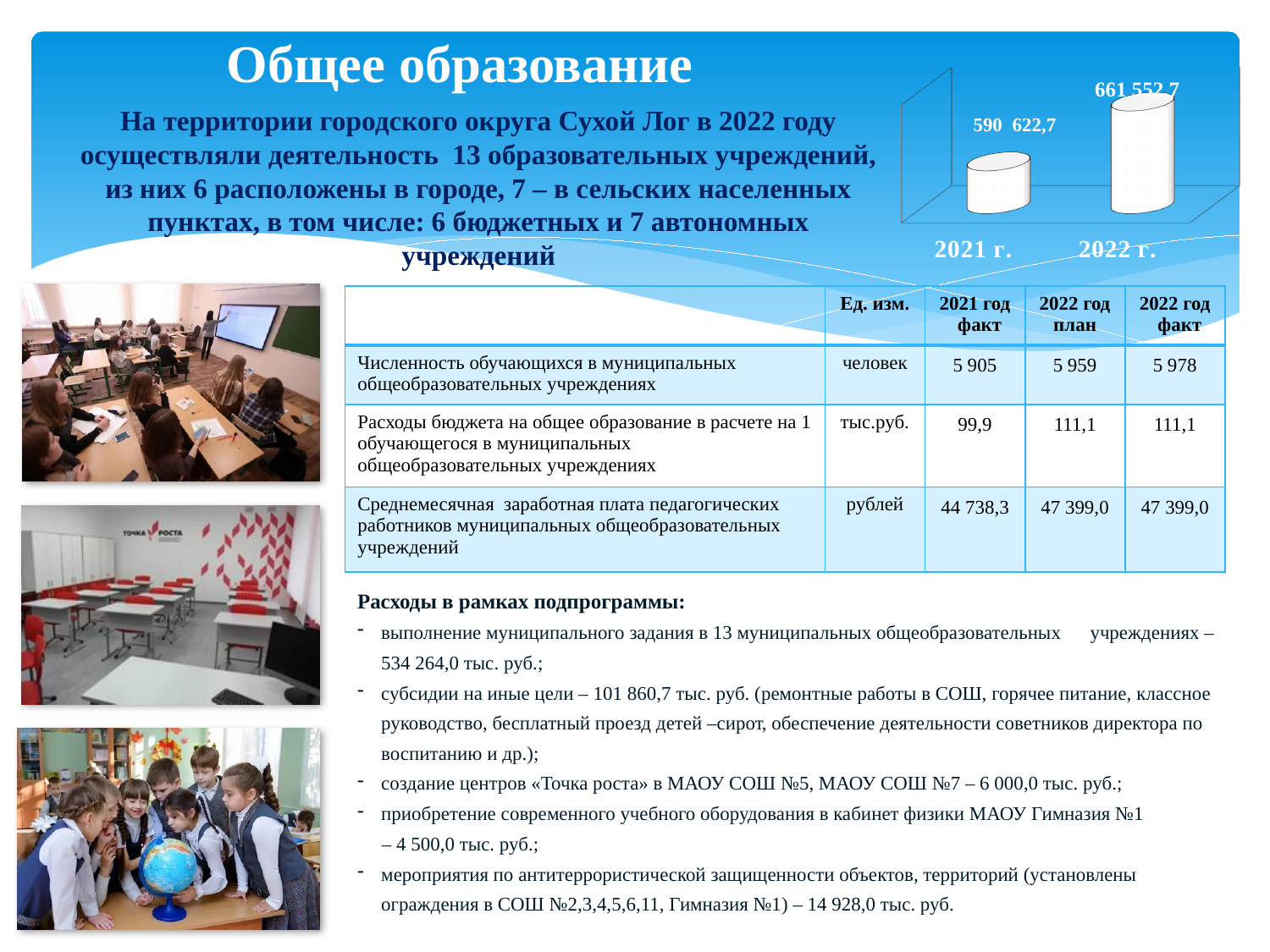
Do the values on the chart rise or fall from 2021 г. to 2022 г.? rise What kind of chart is shown in the top right of the slide? bar chart What value is shown for 2021 г. on the chart? 590 622,7 Is the value for 2021 г. larger or smaller than the value for 2022 г. on the chart? smaller Which year has the higher value on the chart? 2022 г. What are the category labels shown under the bars of the chart? 2021 г. and 2022 г. By how much does the value for 2022 г. exceed the value for 2021 г. on the chart? 70 930,0 Which year has the lower value on the chart? 2021 г. How many categories are plotted on the chart? 2 What value is shown for 2022 г. on the chart? 661 552,7